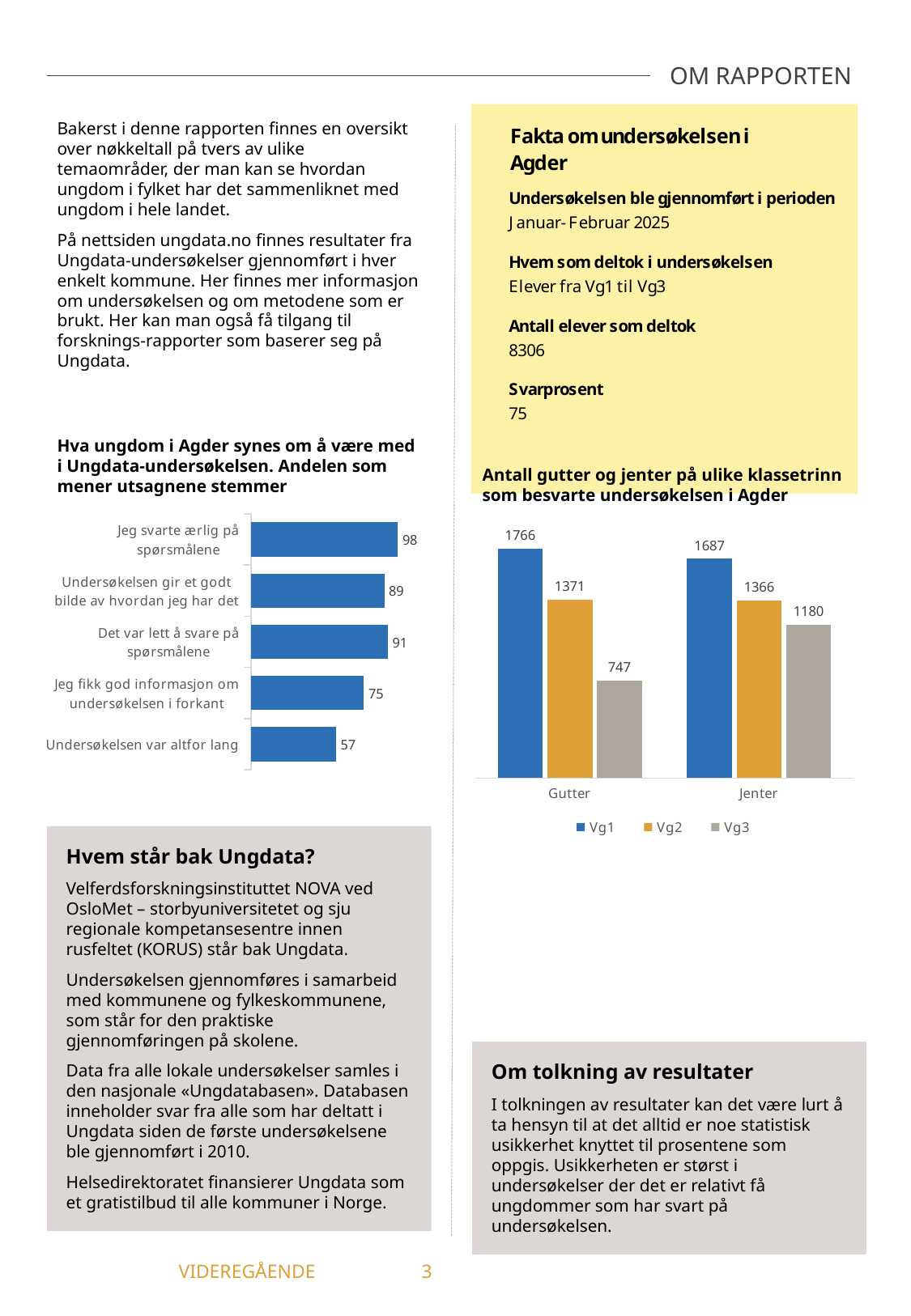
In the chart 'Antall gutter og jenter på ulike klassetrinn som besvarte undersøkelsen i Agder', what is the value for Vg3 among Gutter? 747 In the chart 'Antall gutter og jenter på ulike klassetrinn som besvarte undersøkelsen i Agder', which bar is the highest? Vg1 Gutter (1766) In the chart 'Hva ungdom i Agder synes om å være med i Ungdata-undersøkelsen', what is the value for 'Jeg svarte ærlig på spørsmålene'? 98 How many series does the legend list in the chart 'Antall gutter og jenter på ulike klassetrinn som besvarte undersøkelsen i Agder'? 3 What kind of chart is 'Hva ungdom i Agder synes om å være med i Ungdata-undersøkelsen'? Bar chart In the chart 'Hva ungdom i Agder synes om å være med i Ungdata-undersøkelsen', how many statements are shown? 5 In the chart 'Hva ungdom i Agder synes om å være med i Ungdata-undersøkelsen', what is the difference between 'Det var lett å svare på spørsmålene' and 'Jeg fikk god informasjon om undersøkelsen i forkant'? 16 In the chart 'Hva ungdom i Agder synes om å være med i Ungdata-undersøkelsen', which statement has the lowest value? Undersøkelsen var altfor lang In the chart 'Antall gutter og jenter på ulike klassetrinn som besvarte undersøkelsen i Agder', what is the difference between Vg1 Gutter and Vg1 Jenter? 79 In the chart 'Antall gutter og jenter på ulike klassetrinn som besvarte undersøkelsen i Agder', which is larger: Vg3 for Gutter or Vg3 for Jenter? Vg3 for Jenter In the chart 'Antall gutter og jenter på ulike klassetrinn som besvarte undersøkelsen i Agder', what colour are the Vg2 bars? Orange In the chart 'Antall gutter og jenter på ulike klassetrinn som besvarte undersøkelsen i Agder', what is the value for Vg1 among Jenter? 1687